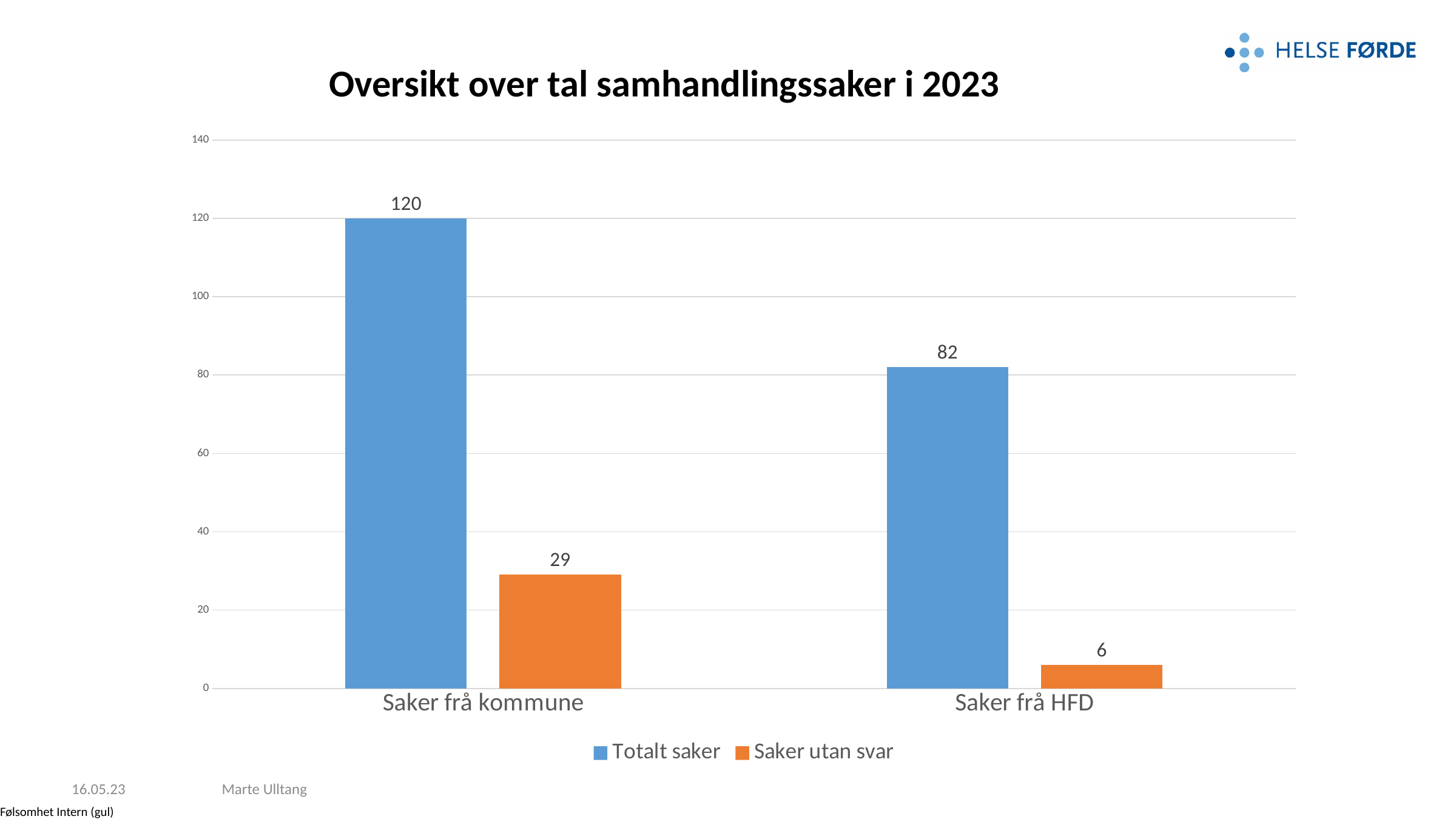
What is the value of Totalt saker for Saker frå kommune? 120 What is the value of Saker utan svar for Saker frå HFD? 6 Which is larger: Saker utan svar for Saker frå kommune or Saker utan svar for Saker frå HFD? Saker frå kommune What is the difference between Totalt saker and Saker utan svar for Saker frå HFD? 76 What is the difference between Totalt saker for Saker frå kommune and Saker frå HFD? 38 Which category has the lowest Saker utan svar value? Saker frå HFD What type of chart is shown on the slide? Bar chart Which category has the highest Totalt saker value? Saker frå kommune What is the value of Totalt saker for Saker frå HFD? 82 How many categories are shown on the x axis? 2 What is the value of Saker utan svar for Saker frå kommune? 29 How many series does the legend list? 2